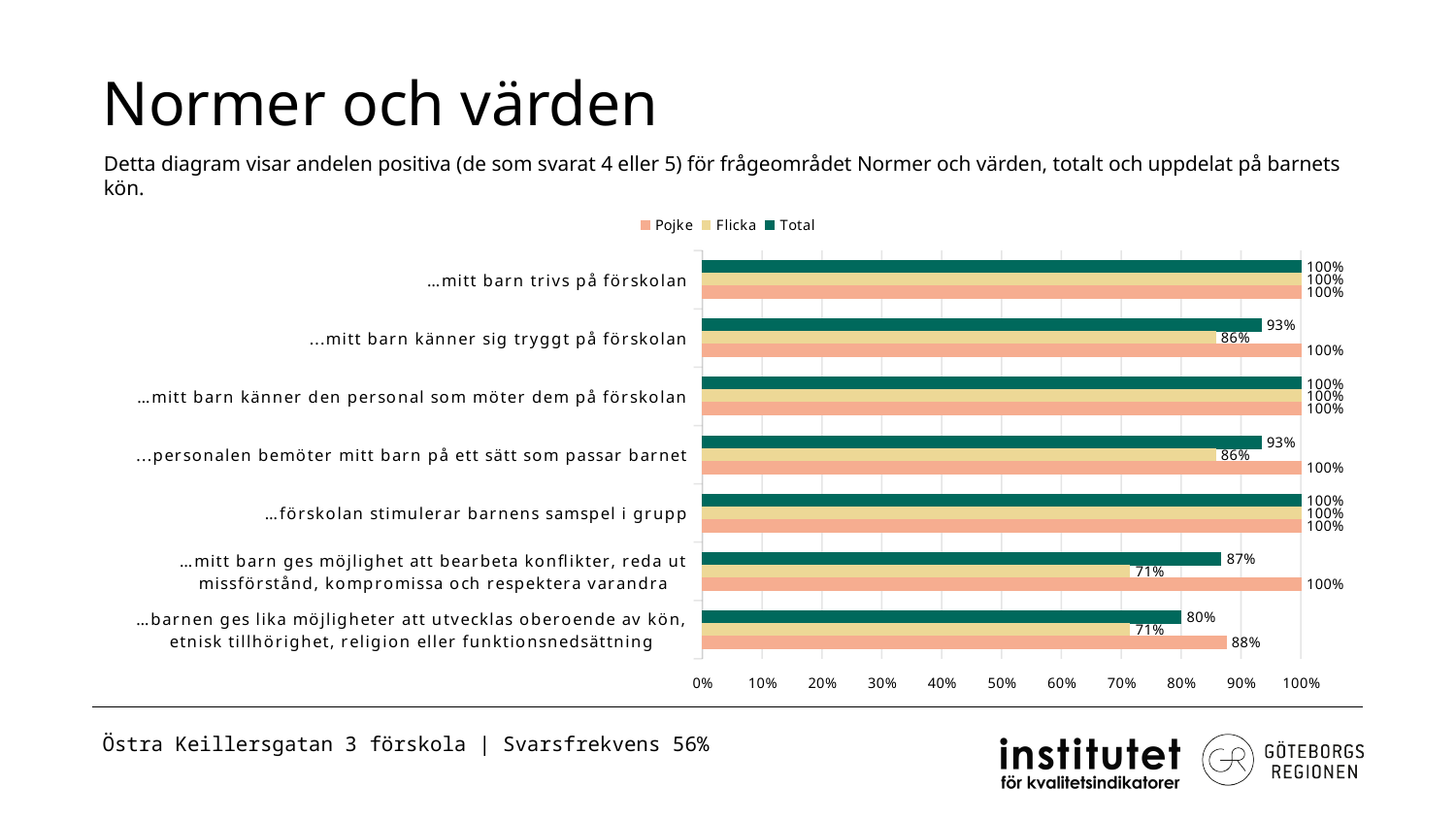
For "...personalen bemöter mitt barn på ett sätt som passar barnet", which is larger, the Pojke value or the Flicka value? Pojke What is the Flicka value for "...mitt barn känner sig tryggt på förskolan"? 86% What is the Total value for "…mitt barn ges möjlighet att bearbeta konflikter, reda ut missförstånd, kompromissa och respektera varandra"? 87% Which series is shown in dark green in the legend? Total What kind of chart is shown on the slide? bar chart How many categories (statements) are plotted on the chart? 7 What is the Total value for "…barnen ges lika möjligheter att utvecklas oberoende av kön, etnisk tillhörighet, religion eller funktionsnedsättning"? 80% What is the difference between the Pojke and Flicka values for "…mitt barn ges möjlighet att bearbeta konflikter, reda ut missförstånd, kompromissa och respektera varandra"? 29% How many series does the legend list? 3 Which category has the lowest Total value? …barnen ges lika möjligheter att utvecklas oberoende av kön, etnisk tillhörighet, religion eller funktionsnedsättning What is the Pojke value for "…barnen ges lika möjligheter att utvecklas oberoende av kön, etnisk tillhörighet, religion eller funktionsnedsättning"? 88% What is the difference between the Total and Flicka values for "...mitt barn känner sig tryggt på förskolan"? 7%